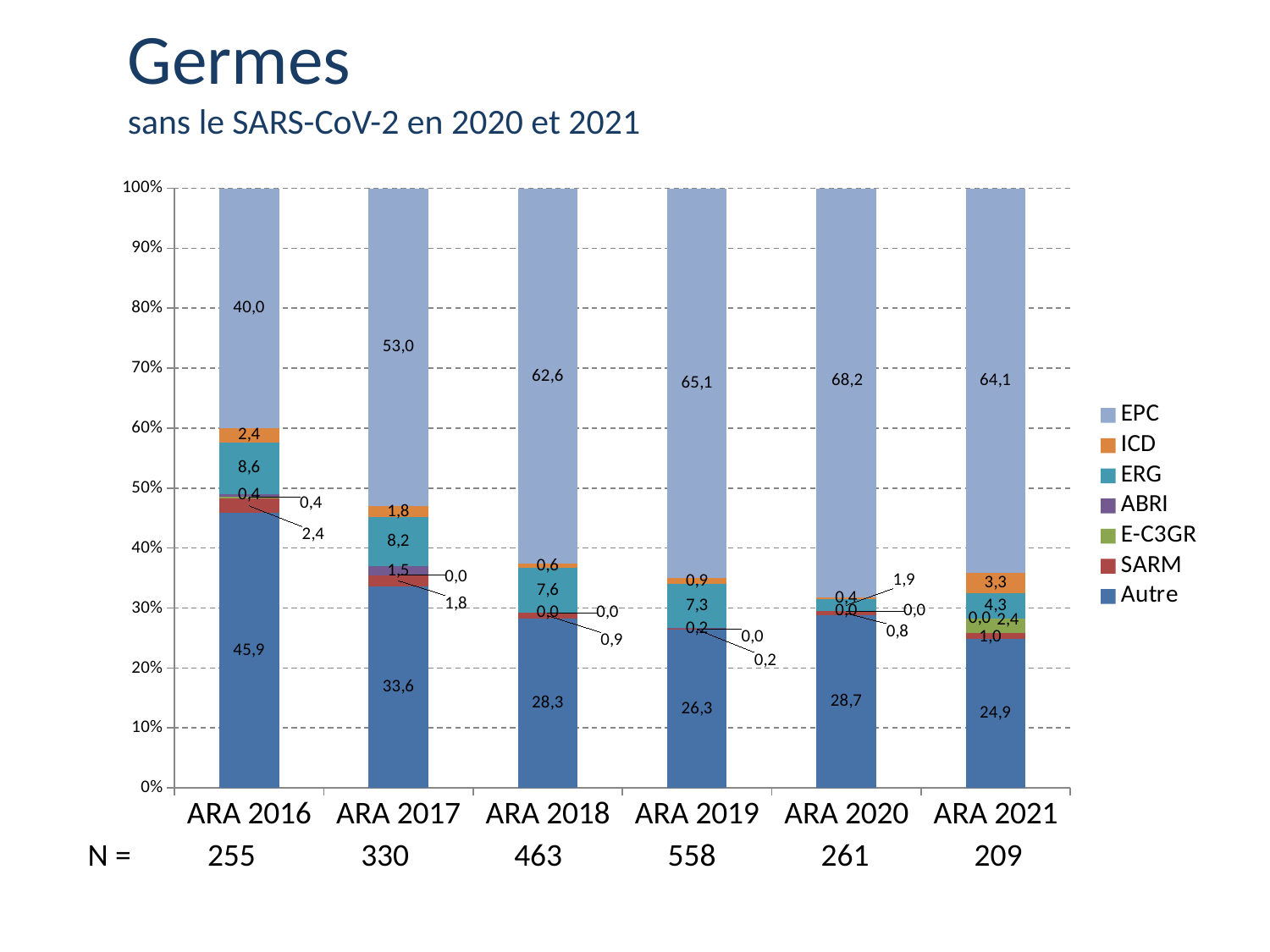
What is the ICD value for ARA 2021? 3,3 What is the EPC value for ARA 2020? 68,2 What is the ERG value for ARA 2018? 7,6 What is the Autre value for ARA 2016? 45,9 Which category has the lowest Autre value? ARA 2021 What is the N value shown for ARA 2019? 558 What kind of chart is shown on the slide? Stacked bar chart What is the difference between the EPC values for ARA 2017 and ARA 2016? 13,0 How many categories are shown on the x axis? 6 Which category has the highest EPC value? ARA 2020 How many series does the legend list? 7 Which is larger, the ERG value for ARA 2016 or for ARA 2021? ARA 2016